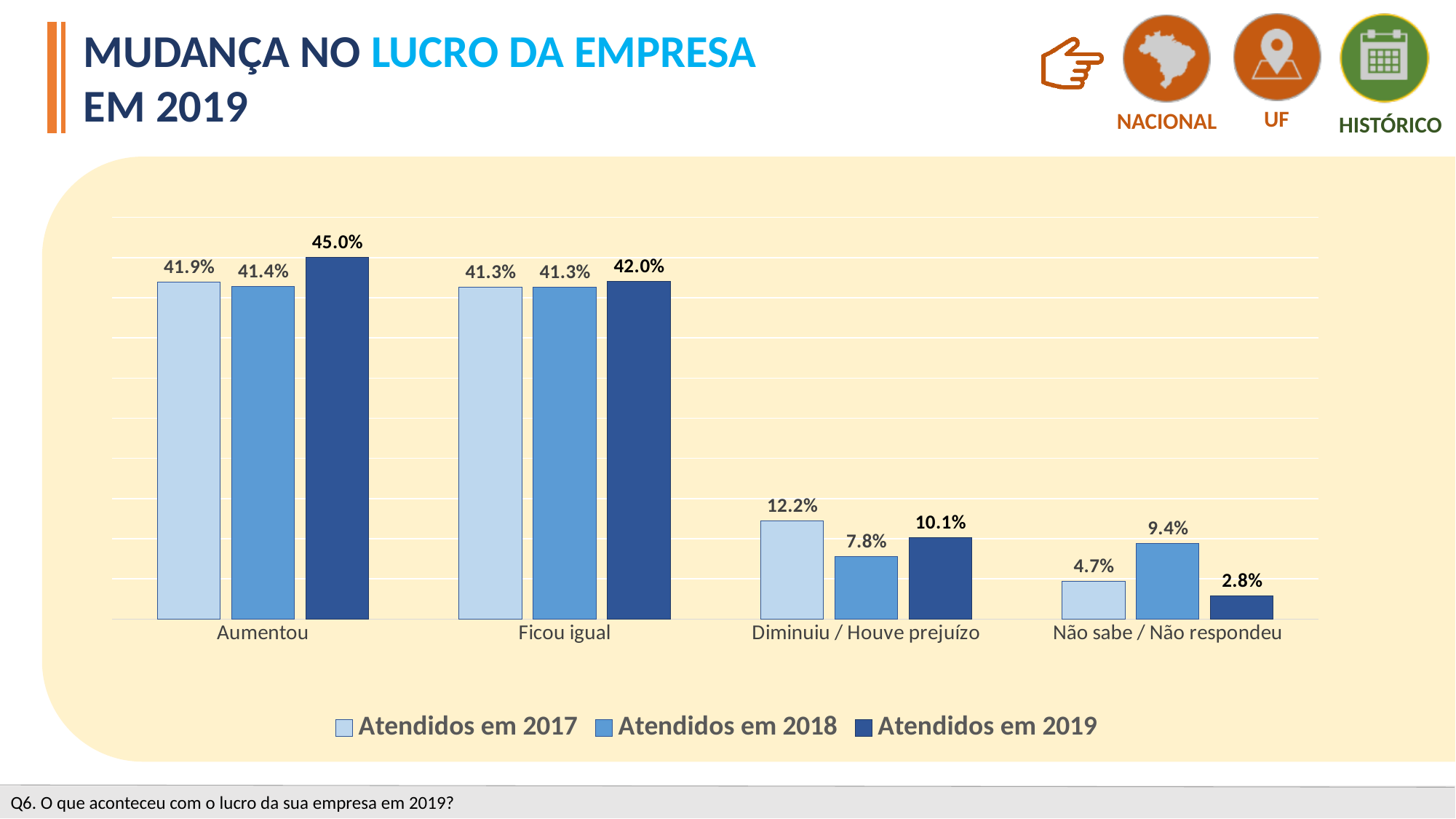
What is the difference between the 'Atendidos em 2017' and 'Atendidos em 2018' values for 'Diminuiu / Houve prejuízo'? 4.4% Which category has the lowest value in the 'Atendidos em 2017' series? Não sabe / Não respondeu How many series does the legend list? 3 What is the title of the slide? MUDANÇA NO LUCRO DA EMPRESA EM 2019 What is the difference between the 'Atendidos em 2019' and 'Atendidos em 2018' values for 'Aumentou'? 3.6% Which category has the highest value in the 'Atendidos em 2019' series? Aumentou For 'Não sabe / Não respondeu', which series has the larger value: 'Atendidos em 2018' or 'Atendidos em 2019'? Atendidos em 2018 What is the value for 'Não sabe / Não respondeu' in the 'Atendidos em 2018' series? 9.4% What is the value for 'Diminuiu / Houve prejuízo' in the 'Atendidos em 2017' series? 12.2% What is the value for 'Aumentou' in the 'Atendidos em 2019' series? 45.0% How many categories are shown on the x axis? 4 What kind of chart is shown on the slide? Bar chart